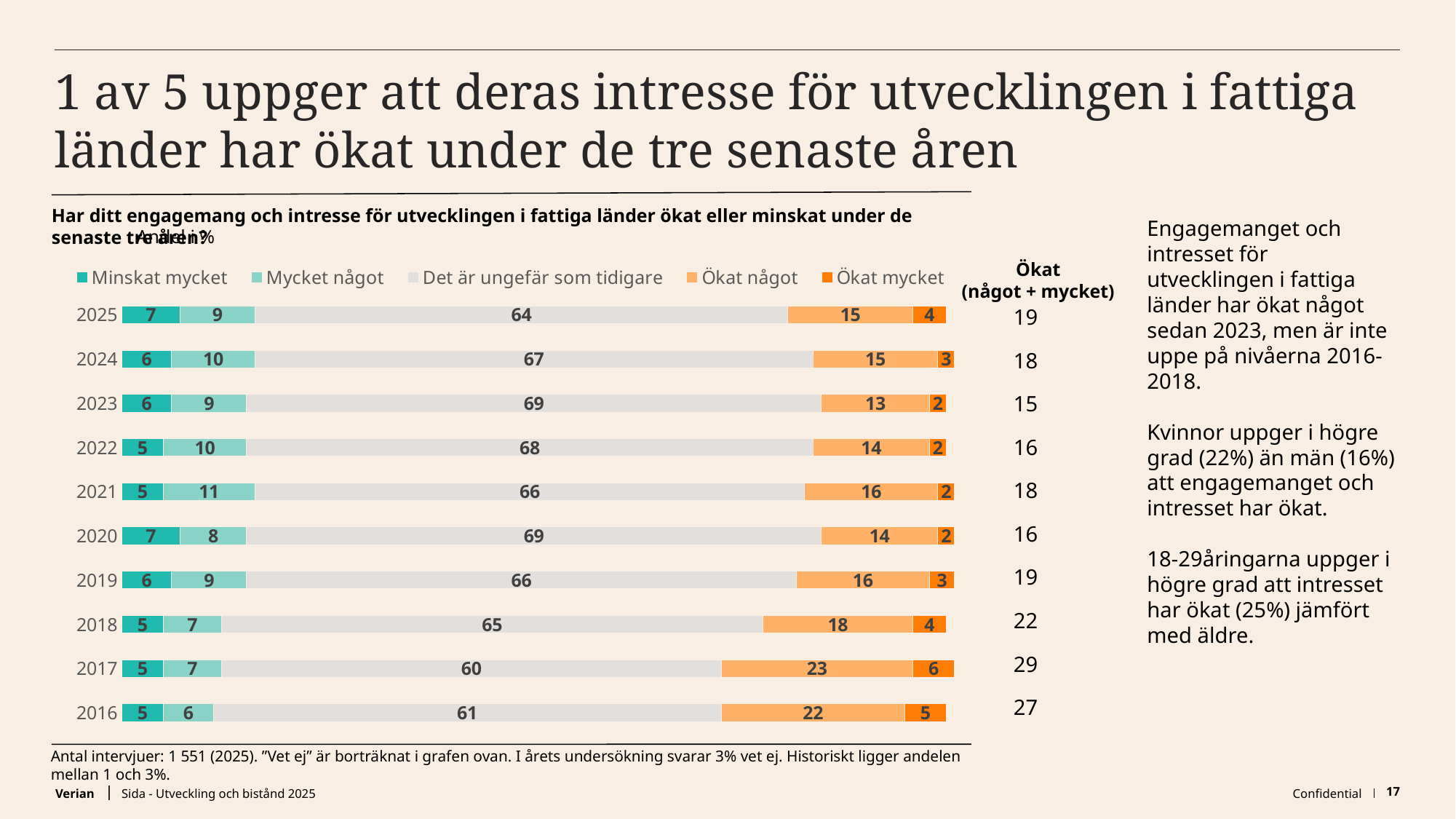
What is the difference between the "Ökat något" values for 2018 and 2023? 5 What is the "Ökat (något + mycket)" figure shown for 2018? 22 Which year has the larger value for "Minskat mycket", 2025 or 2024? 2025 What is the total of the stacked bar for 2025? 99 What is the value for "Det är ungefär som tidigare" in 2025? 64 Which year has the highest value for "Ökat något"? 2017 Which year has the lowest value for "Det är ungefär som tidigare"? 2017 What is the value for "Mycket något" in 2021? 11 How many years are shown in the chart? 10 How many series does the legend list? 5 What kind of chart is shown on the slide? Stacked bar chart What is the value for "Ökat något" in 2017? 23